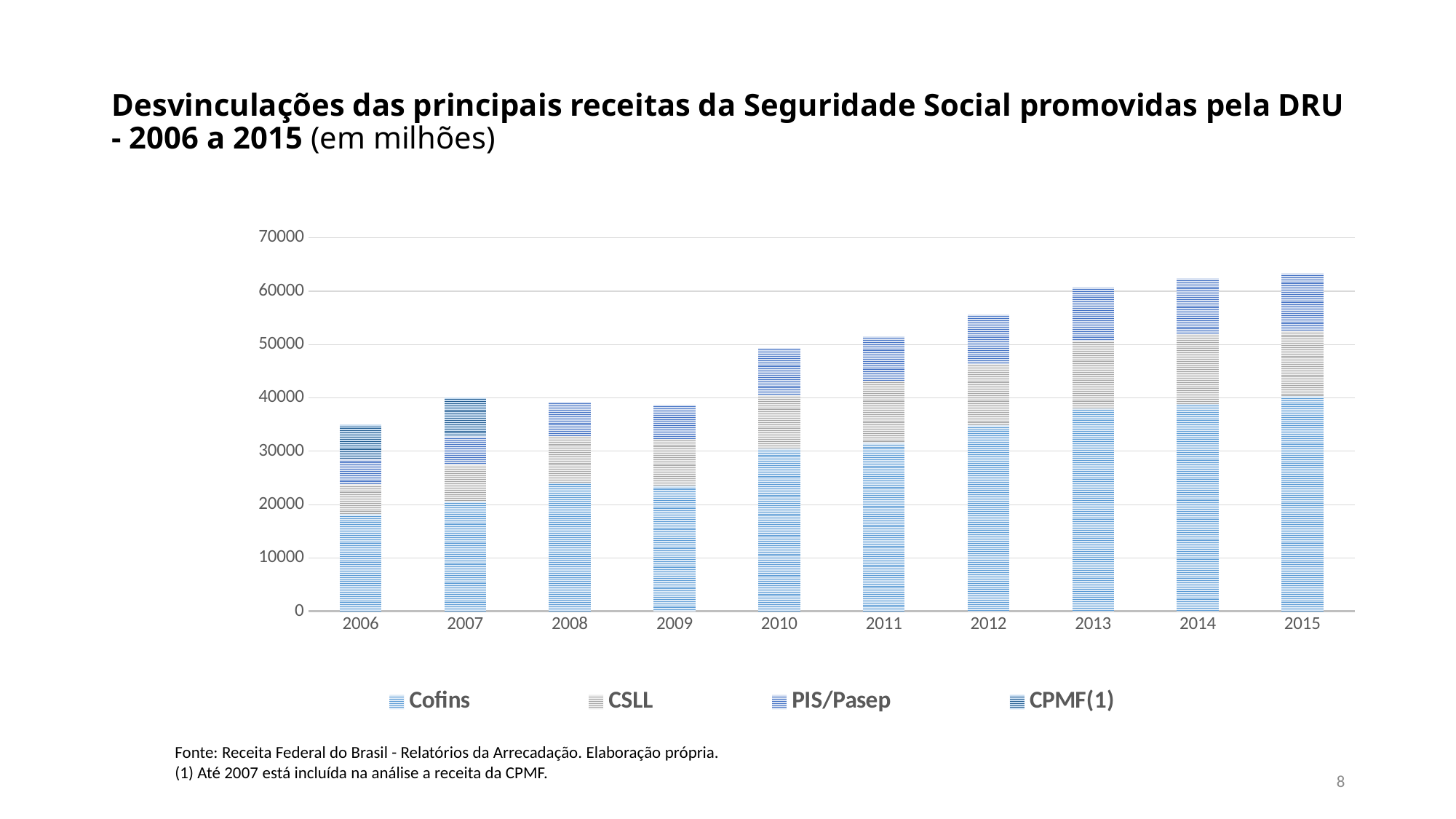
Is the total for 2012 greater or less than 50000? greater Is the total for 2006 greater or less than 40000? less How many years are shown on the x axis of the chart? 10 Which series is listed first in the chart's legend? Cofins What kind of chart is shown on the slide? Stacked bar chart Do the total bars rise or fall from 2009 to 2015? rise Is the total for 2009 greater or less than 40000? less Which year has the larger total bar, 2008 or 2012? 2012 How many series does the chart's legend list? 4 Which year has the larger total bar, 2009 or 2010? 2010 Which year has the lowest total bar in the chart? 2006